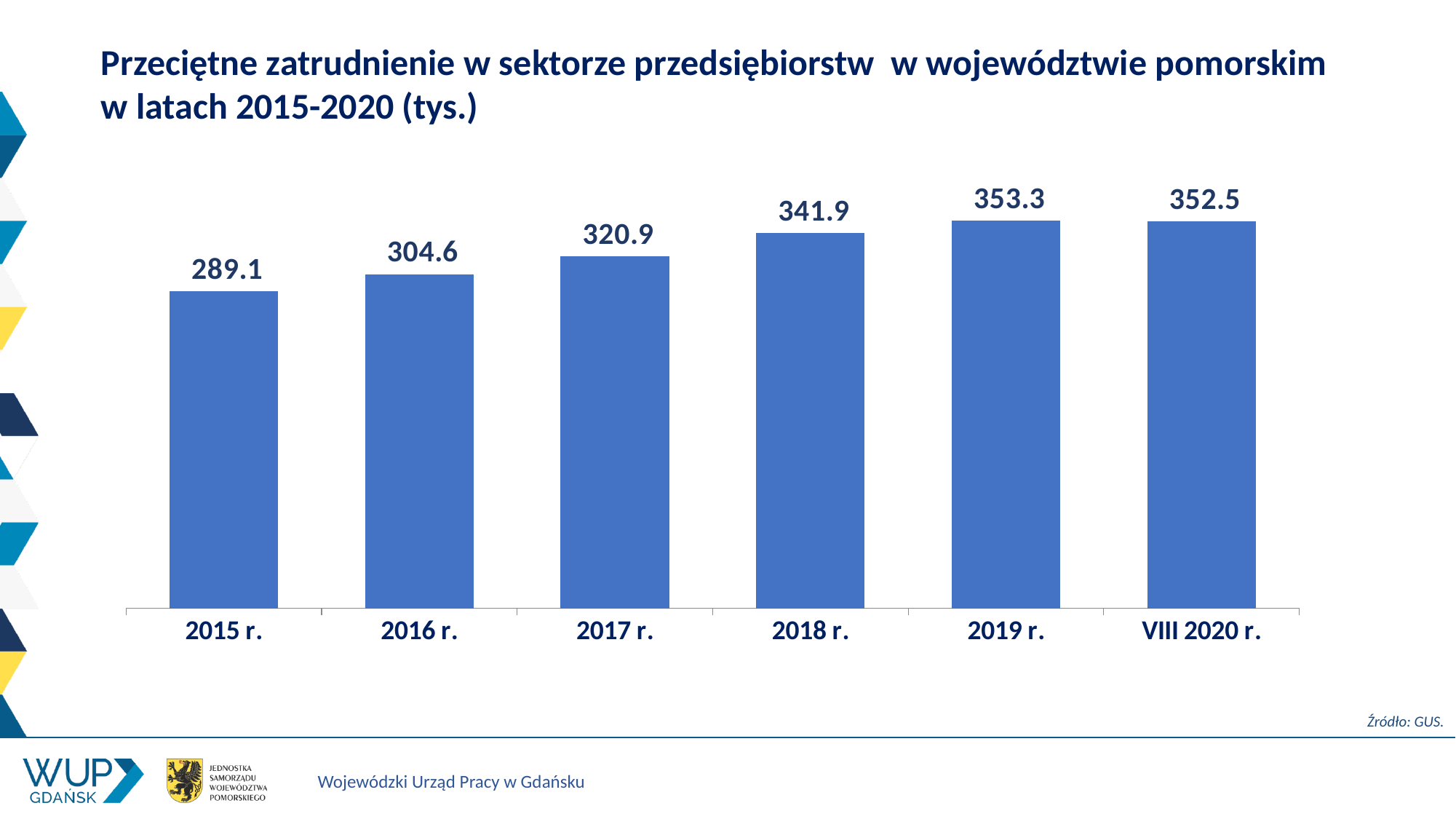
What is the value for 2015 r.? 289.1 What is the difference between the values for 2017 r. and 2016 r.? 16.3 Which category has the highest value? 2019 r. What is the difference between the values for 2019 r. and 2015 r.? 64.2 Which category has the lowest value? 2015 r. Which is larger, the value for 2016 r. or the value for 2018 r.? 2018 r. What is the value for 2018 r.? 341.9 What source is cited for the chart? GUS How many categories are shown on the x axis? 6 What kind of chart is shown on the slide? bar chart Do the values rise or fall from 2015 r. to 2019 r.? rise What is the value for VIII 2020 r.? 352.5